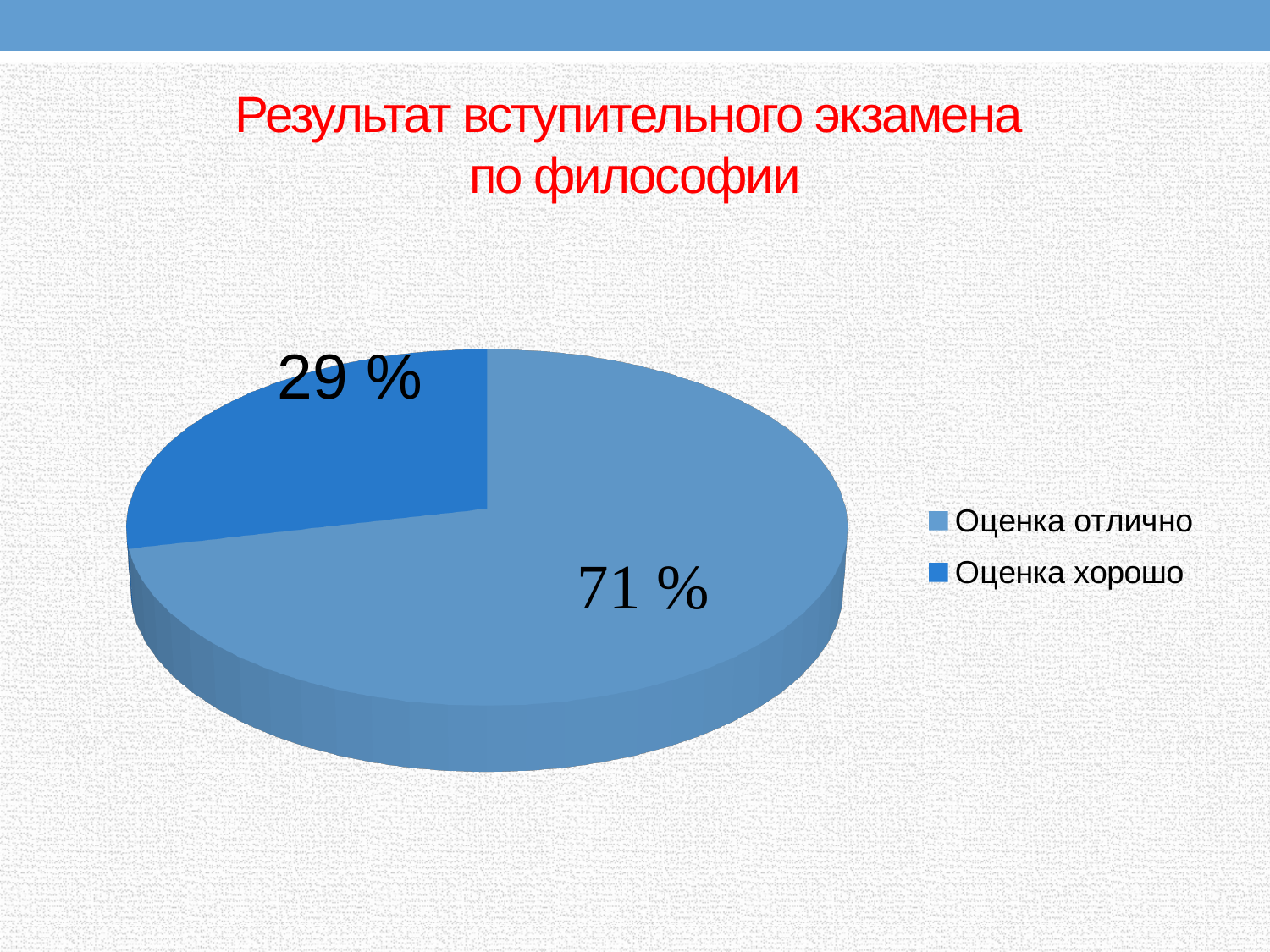
Which category has the largest slice of the pie? Оценка отлично What kind of chart is shown on the slide? Pie chart How many entries does the legend list? 2 Which legend entry is shown in the darker blue colour? Оценка хорошо Which category has the smallest slice of the pie? Оценка хорошо Which is larger, the slice for "Оценка отлично" or the slice for "Оценка хорошо"? Оценка отлично What share of the pie does "Оценка хорошо" have? 29 % How many slices does the pie chart have? 2 What share of the pie does "Оценка отлично" have? 71 % What is the difference in percentage points between the "Оценка отлично" slice and the "Оценка хорошо" slice? 42 What is the title of the slide? Результат вступительного экзамена по философии